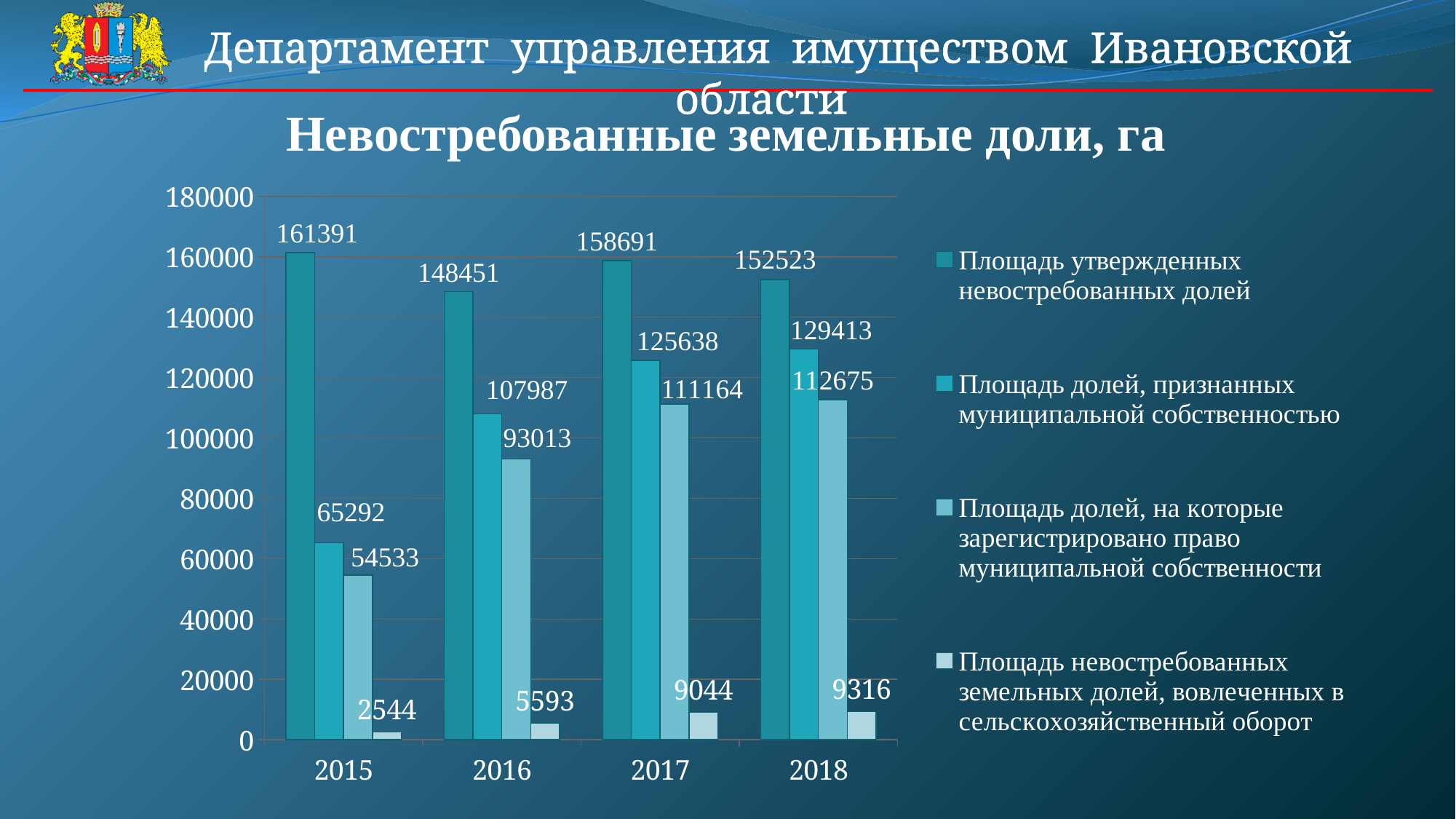
In which year is 'Площадь долей, признанных муниципальной собственностью' the lowest? 2015 What is the value of 'Площадь долей, на которые зарегистрировано право муниципальной собственности' for 2016? 93013 What is the value of 'Площадь долей, признанных муниципальной собственностью' for 2017? 125638 Which is larger: 'Площадь долей, признанных муниципальной собственностью' in 2016 or 'Площадь долей, на которые зарегистрировано право муниципальной собственности' in 2017? Площадь долей, на которые зарегистрировано право муниципальной собственности in 2017 What is the difference between 'Площадь утвержденных невостребованных долей' in 2015 and in 2016? 12940 In which year is 'Площадь утвержденных невостребованных долей' the highest? 2015 Does 'Площадь невостребованных земельных долей, вовлеченных в сельскохозяйственный оборот' rise or fall from 2015 to 2018? Rise How many years are shown on the x axis? 4 What is the value of 'Площадь невостребованных земельных долей, вовлеченных в сельскохозяйственный оборот' for 2018? 9316 What kind of chart is shown on the slide? Bar chart How many series does the legend list? 4 What is the value of 'Площадь утвержденных невостребованных долей' for 2015? 161391